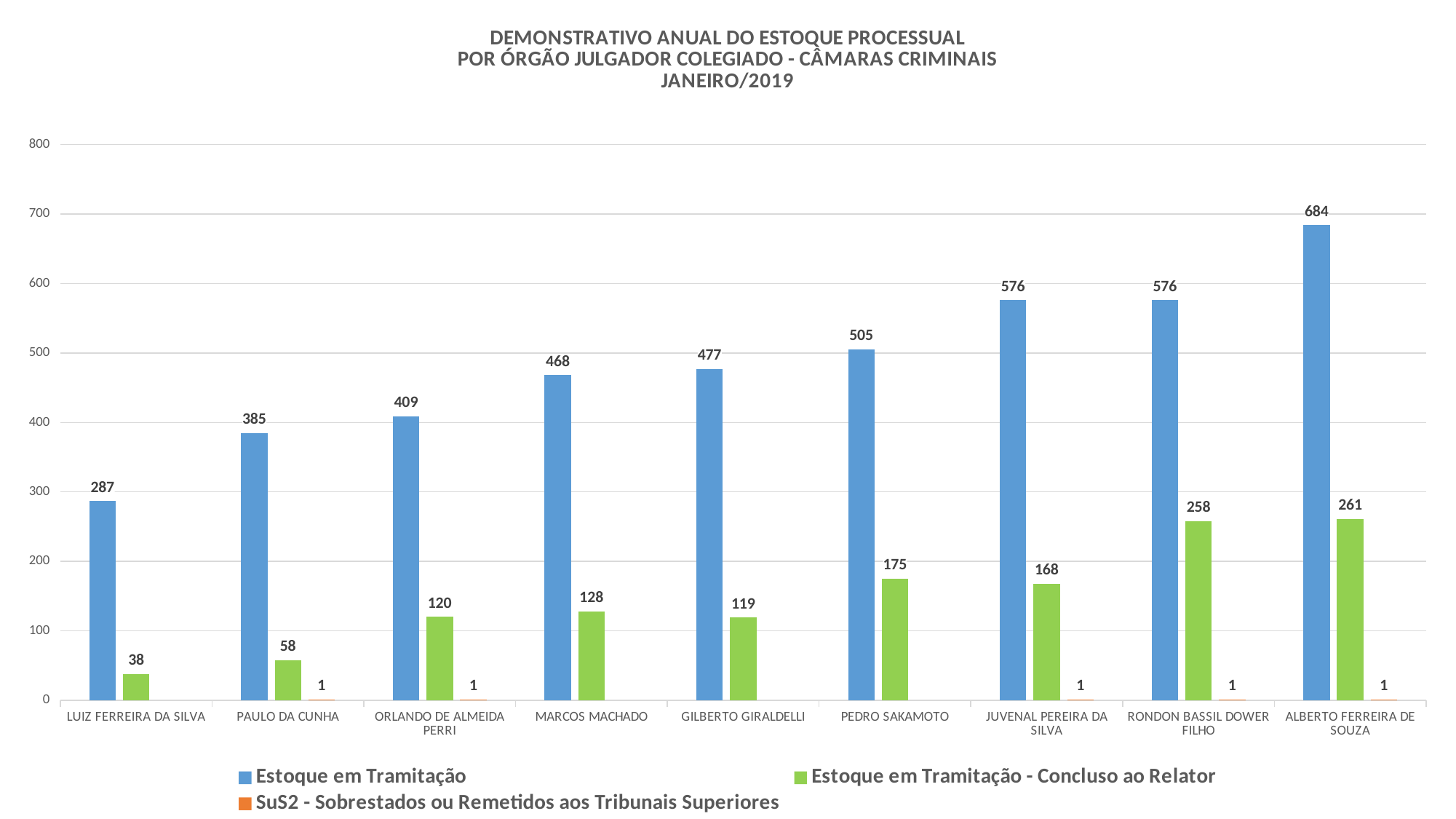
What is the value of Estoque em Tramitação - Concluso ao Relator for PEDRO SAKAMOTO? 175 What is the value of SuS2 - Sobrestados ou Remetidos aos Tribunais Superiores for PAULO DA CUNHA? 1 Which category has the highest value for Estoque em Tramitação? ALBERTO FERREIRA DE SOUZA How many series does the legend list? 3 What is the difference between the Estoque em Tramitação values for ALBERTO FERREIRA DE SOUZA and RONDON BASSIL DOWER FILHO? 108 Is the Estoque em Tramitação value for PEDRO SAKAMOTO greater or less than 500? greater What is the value of Estoque em Tramitação for ALBERTO FERREIRA DE SOUZA? 684 What is the value of Estoque em Tramitação for LUIZ FERREIRA DA SILVA? 287 What kind of chart is shown on the slide? Bar chart How many categories (judges) are shown on the x axis? 9 Which is larger: the Estoque em Tramitação - Concluso ao Relator value for MARCOS MACHADO or for GILBERTO GIRALDELLI? MARCOS MACHADO Which category has the lowest value for Estoque em Tramitação - Concluso ao Relator? LUIZ FERREIRA DA SILVA